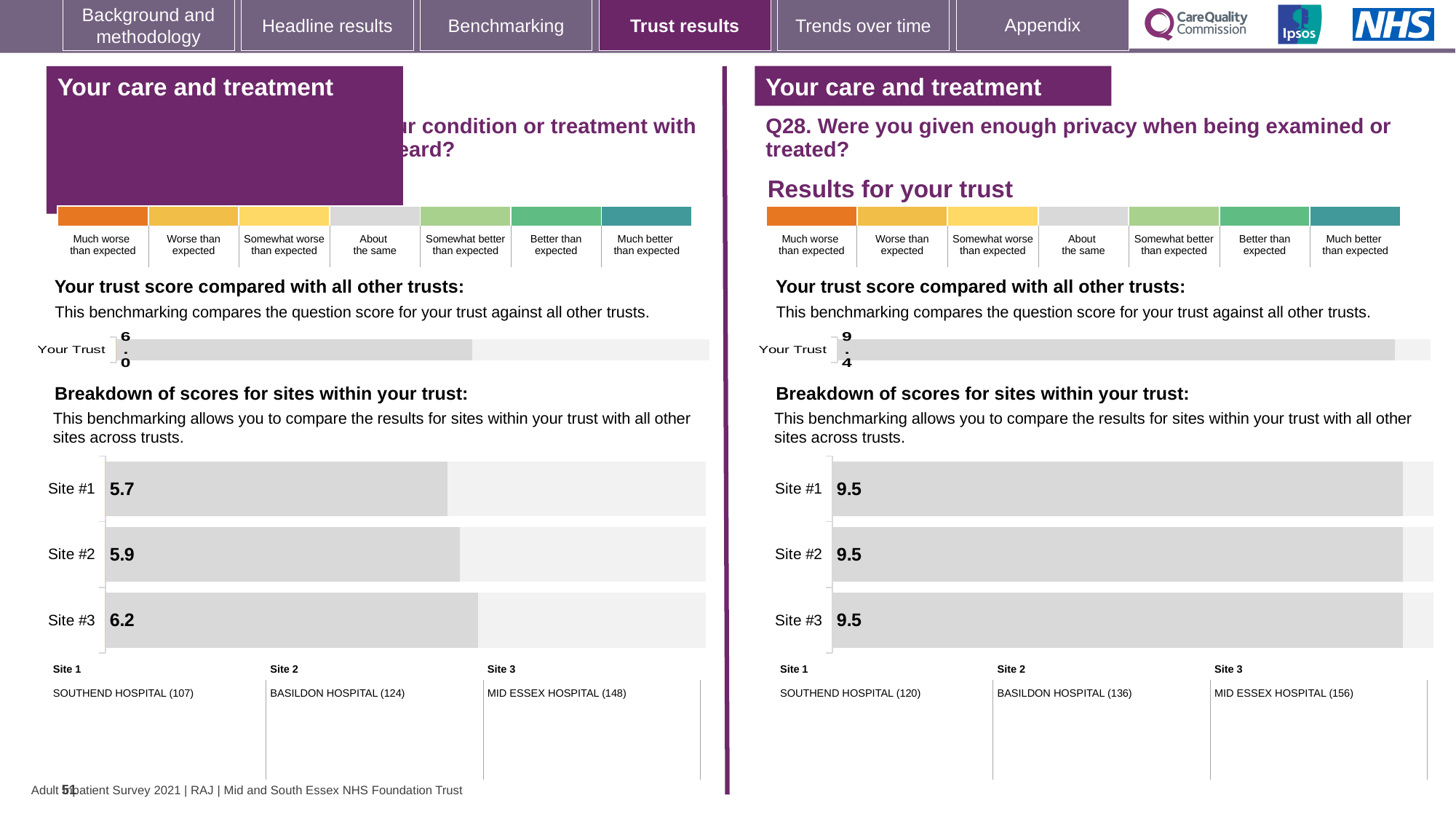
On the left-hand 'Breakdown of scores for sites within your trust' chart, what is the difference between the scores for Site #3 and Site #1? 0.5 On the left-hand 'Breakdown of scores for sites within your trust' chart, which has the larger score, Site #2 or Site #3? Site #3 On the left-hand 'Breakdown of scores for sites within your trust' chart, which site has the highest score? Site #3 On the left-hand 'Breakdown of scores for sites within your trust' chart, what is the score for Site #3? 6.2 On the left-hand 'Your trust score compared with all other trusts' chart, what is the score for Your Trust? 6.0 On the left-hand 'Breakdown of scores for sites within your trust' chart, what is the score for Site #1? 5.7 On the Q28 'Breakdown of scores for sites within your trust' chart, what is the score for Site #2? 9.5 On the left-hand 'Breakdown of scores for sites within your trust' chart, which site has the lowest score? Site #1 On the Q28 'Breakdown of scores for sites within your trust' chart, do the scores rise, fall or stay the same from Site #1 to Site #3? Stay the same How many sites are shown on the Q28 'Breakdown of scores for sites within your trust' chart? 3 On the Q28 'Your trust score compared with all other trusts' chart, what is the score for Your Trust? 9.4 What kind of chart is the Q28 'Breakdown of scores for sites within your trust' chart? Bar chart